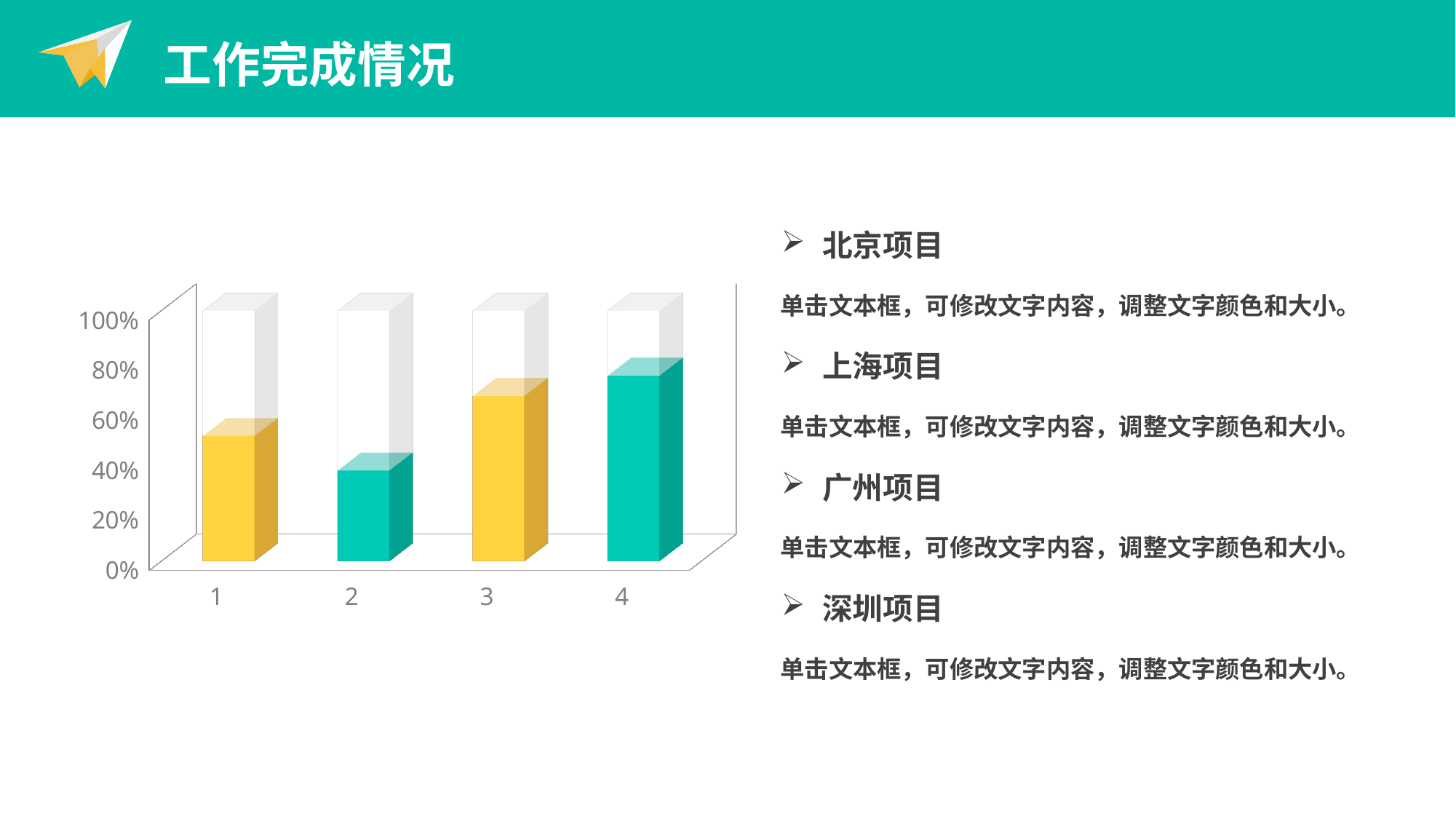
Which category has the lowest bar in the chart? 2 Which is larger, the value for category 1 or the value for category 2? category 1 Which category has the highest bar in the chart? 4 Is the value for category 1 greater or less than 40%? greater Is the value for category 1 greater or less than 60%? less How many categories are plotted on the x axis of the chart? 4 Which is larger, the value for category 3 or the value for category 1? category 3 Is the value for category 3 greater or less than 60%? greater What kind of chart is shown on the slide? bar chart What colour are the bars for categories 1 and 3 in the chart? yellow